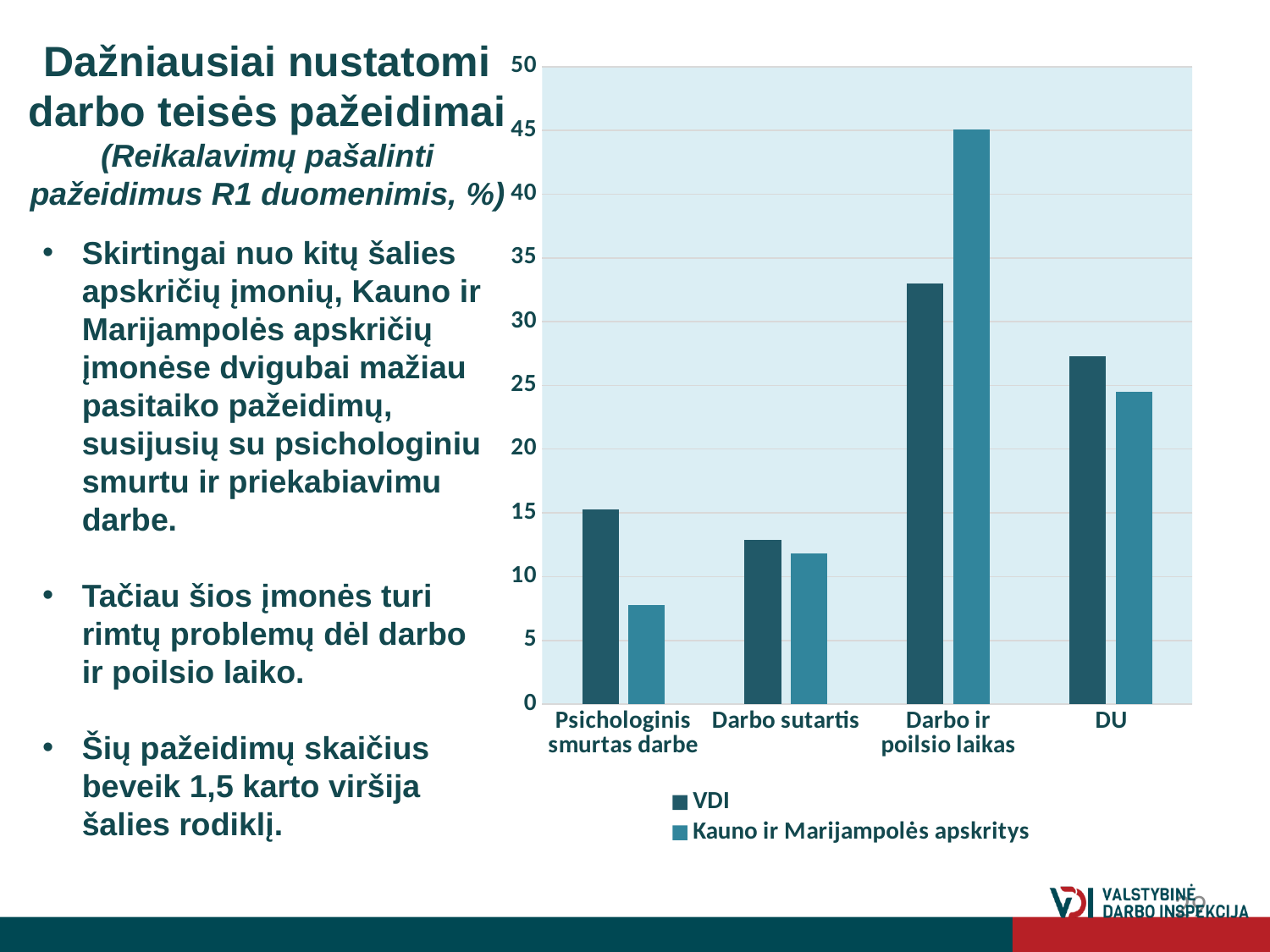
For Darbo ir poilsio laikas, which series has the larger value, VDI or Kauno ir Marijampolės apskritys? Kauno ir Marijampolės apskritys How many series does the chart legend list? 2 Which category has the highest value for the Kauno ir Marijampolės apskritys series? Darbo ir poilsio laikas Which category has the lowest value for the Kauno ir Marijampolės apskritys series? Psichologinis smurtas darbe Is the Kauno ir Marijampolės apskritys value for Psichologinis smurtas darbe greater or less than 10? less How many categories are shown on the x axis of the chart? 4 What are the two series named in the chart legend? VDI; Kauno ir Marijampolės apskritys For Psichologinis smurtas darbe, which series has the larger value, VDI or Kauno ir Marijampolės apskritys? VDI What kind of chart is shown on the slide? bar chart Which category has the lowest value for the VDI series? Darbo sutartis Is the VDI value for Darbo ir poilsio laikas greater or less than 30? greater Which category has the highest value for the VDI series? Darbo ir poilsio laikas